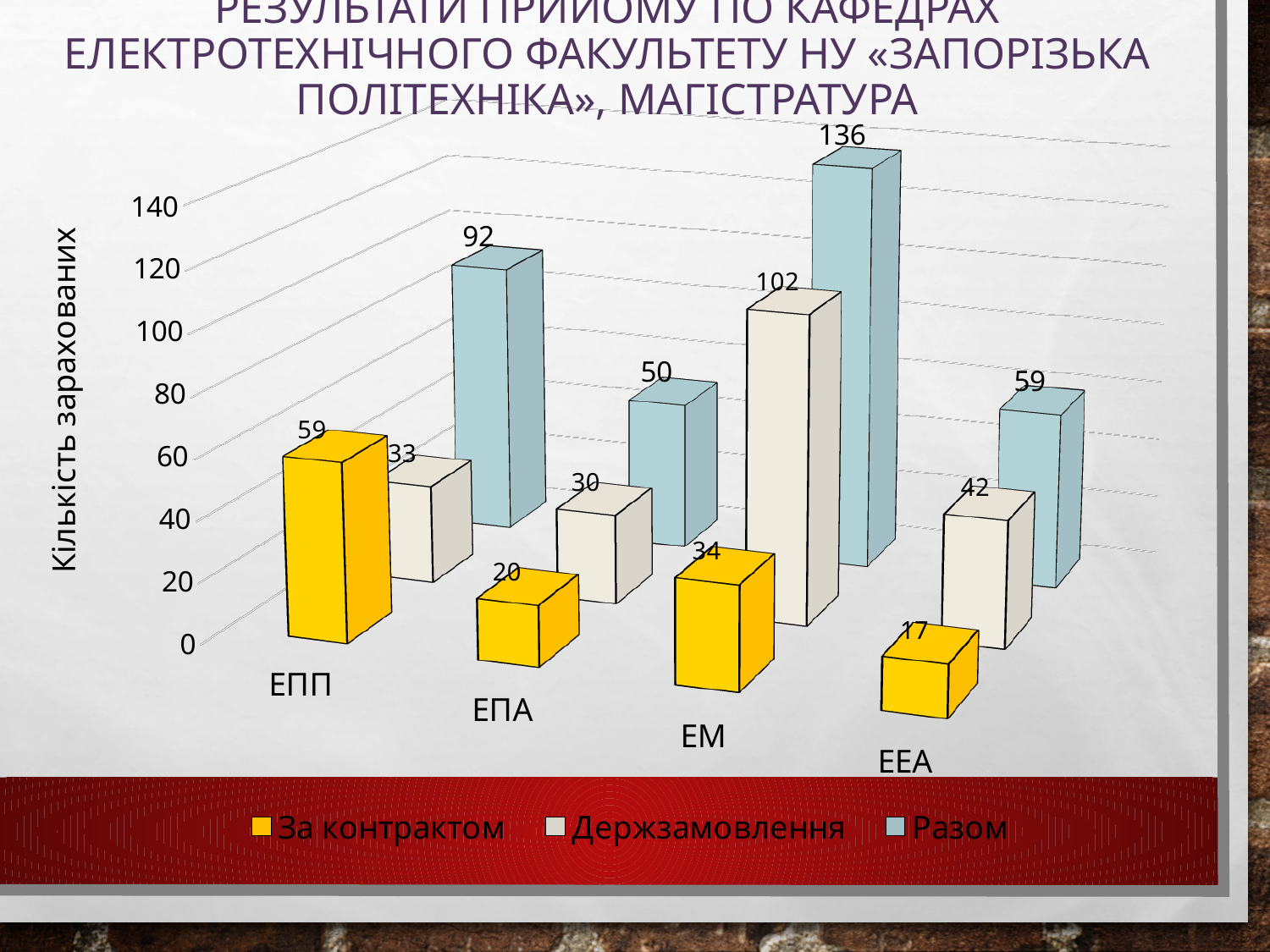
What is the value for ЕМ in the Разом series? 136 Which category has the lowest value in the За контрактом series? ЕЕА Which is larger: the Разом value for ЕПП or the Разом value for ЕЕА? ЕПП What is the value for ЕЕА in the Держзамовлення series? 42 Which category has the highest value in the Разом series? ЕМ What is the difference between the Держзамовлення values for ЕМ and ЕПА? 72 Which series is shown in yellow? За контрактом What is the label of the vertical axis? Кількість зарахованих What is the value for ЕПП in the За контрактом series? 59 How many categories are shown on the x axis? 4 How many series does the legend list? 3 What kind of chart is shown on the slide? Bar chart